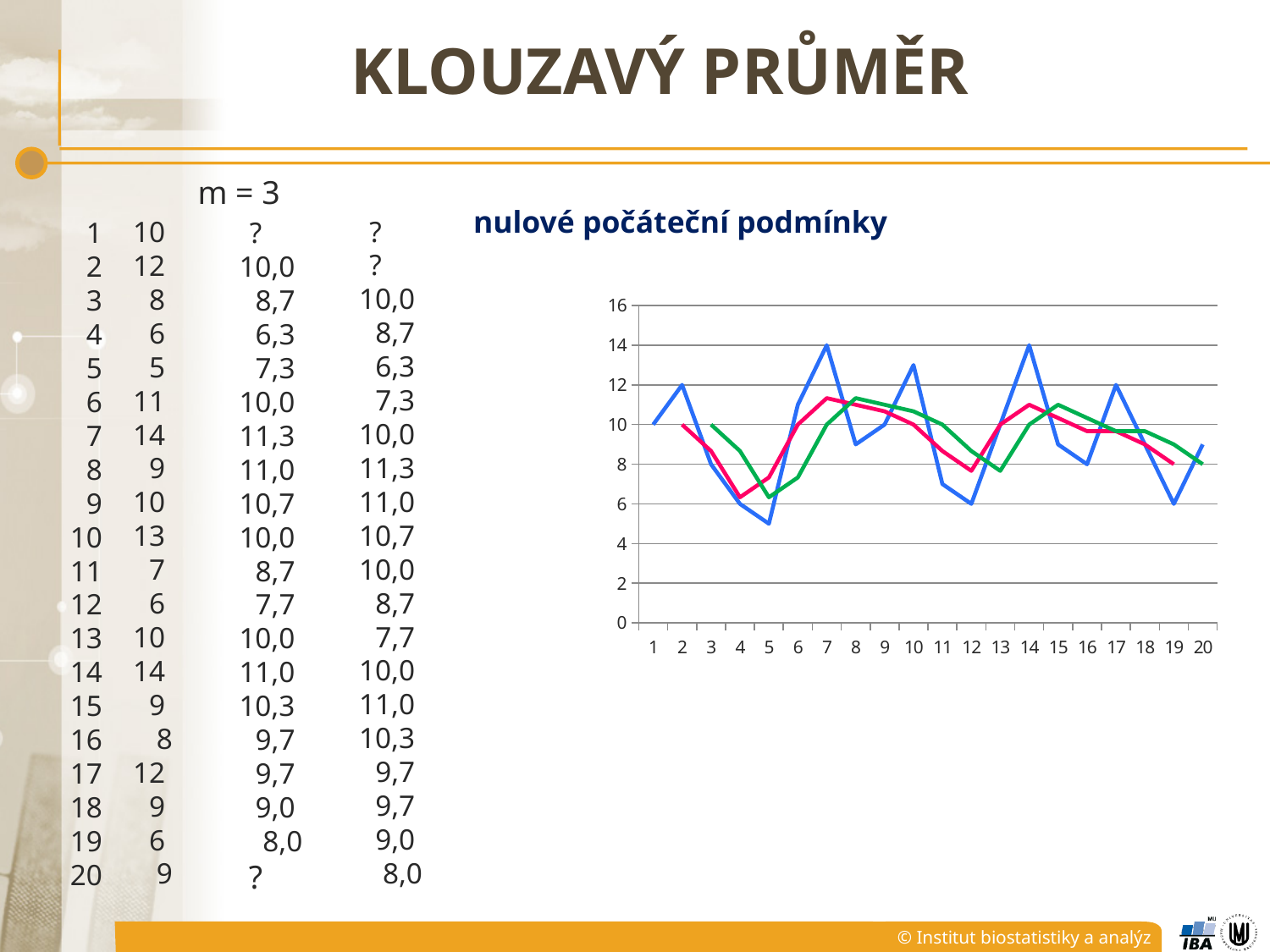
How many points are labelled along the x axis of the chart? 20 What is the value of the blue line at x = 1? 10 How many lines are plotted on the chart? 3 Is the value of the red line at x = 4 greater or less than 8? less Does the blue line rise or fall between x = 4 and x = 7? rise What is the value of the blue line at x = 12? 6 What is the maximum value shown on the y axis of the chart? 16 Is the value of the blue line at x = 10 greater or less than 12? greater Is the value of the green line at x = 8 greater or less than 10? greater What is the highest value reached by the blue line on the chart? 14 At which x-axis point does the blue line reach its lowest value? 5 What kind of chart is shown on the slide? line chart